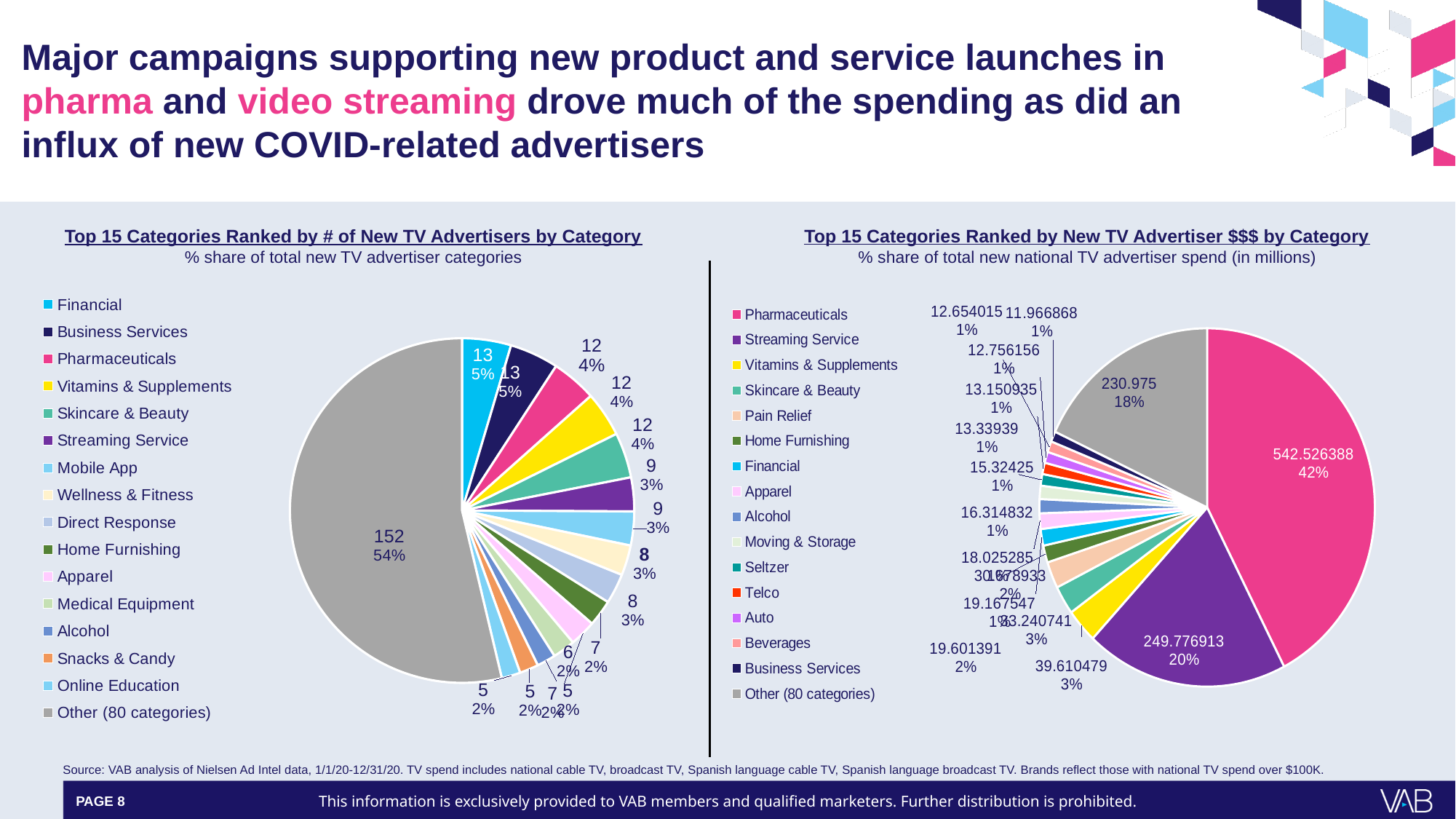
In the left chart (ranked by # of new TV advertisers), how many new TV advertisers are in the Financial category? 13 In the right chart (ranked by new TV advertiser $$$), which is larger: the Pharmaceuticals slice or the Streaming Service slice? Pharmaceuticals In the left chart (ranked by # of new TV advertisers), how many new TV advertisers are in the 'Other (80 categories)' slice? 152 In the right chart (ranked by new TV advertiser $$$), what is the spend value shown for Pharmaceuticals? 542.526388 In the left chart (ranked by # of new TV advertisers), what share of the pie does 'Other (80 categories)' represent? 54% In the right chart (ranked by new TV advertiser $$$), by how many percentage points does the Pharmaceuticals share exceed the Streaming Service share? 22% In the left chart (ranked by # of new TV advertisers), which category has the largest slice? Other (80 categories) In the right chart (ranked by new TV advertiser $$$), what share of the pie does Streaming Service represent? 20% In the right chart (ranked by new TV advertiser $$$), what share of the pie does Pharmaceuticals represent? 42% How many entries does the legend of the left chart (ranked by # of new TV advertisers) list? 16 What kind of chart is the left chart, 'Top 15 Categories Ranked by # of New TV Advertisers by Category'? pie chart In the right chart (ranked by new TV advertiser $$$), what is the spend value shown for 'Other (80 categories)'? 230.975